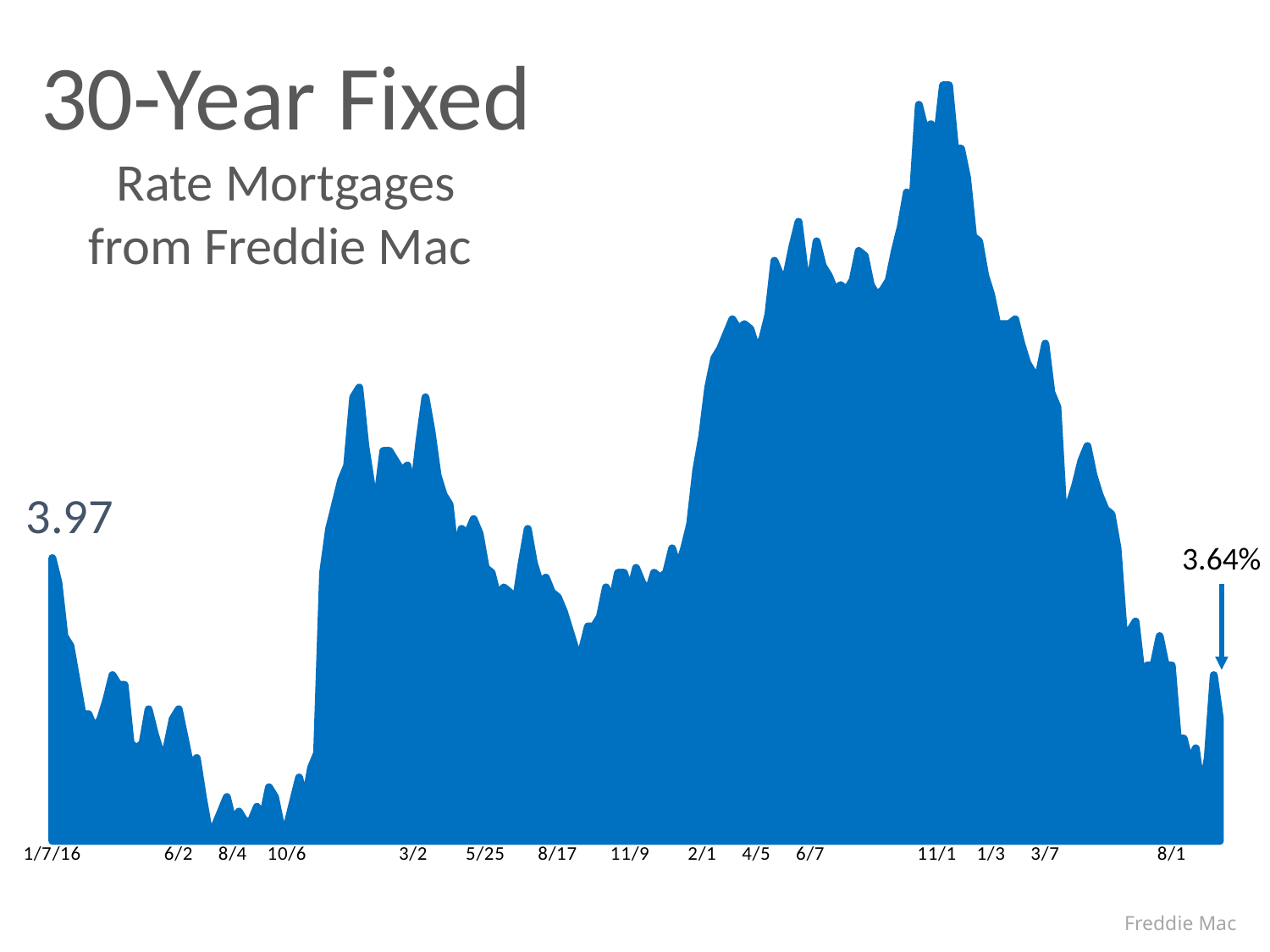
How many date labels are shown along the x axis? 15 What is the value labelled at the end of the chart, marked with an arrow? 3.64% What source is credited at the bottom right of the slide? Freddie Mac What is the difference between the starting value (3.97) and the ending value (3.64%)? 0.33 Overall, is the rate at the end of the chart higher or lower than at the start? Lower Near which x-axis label does the chart reach its highest point? 11/1 What is the title of the chart? 30-Year Fixed Rate Mortgages from Freddie Mac Which is larger, the value at the start of the chart or the value at the end? The start (3.97) Near which x-axis label does the chart reach its lowest point? 8/4 What is the value labelled at the start of the chart (1/7/16)? 3.97 What kind of chart is shown on the slide? Area chart What is the first date label on the x axis? 1/7/16